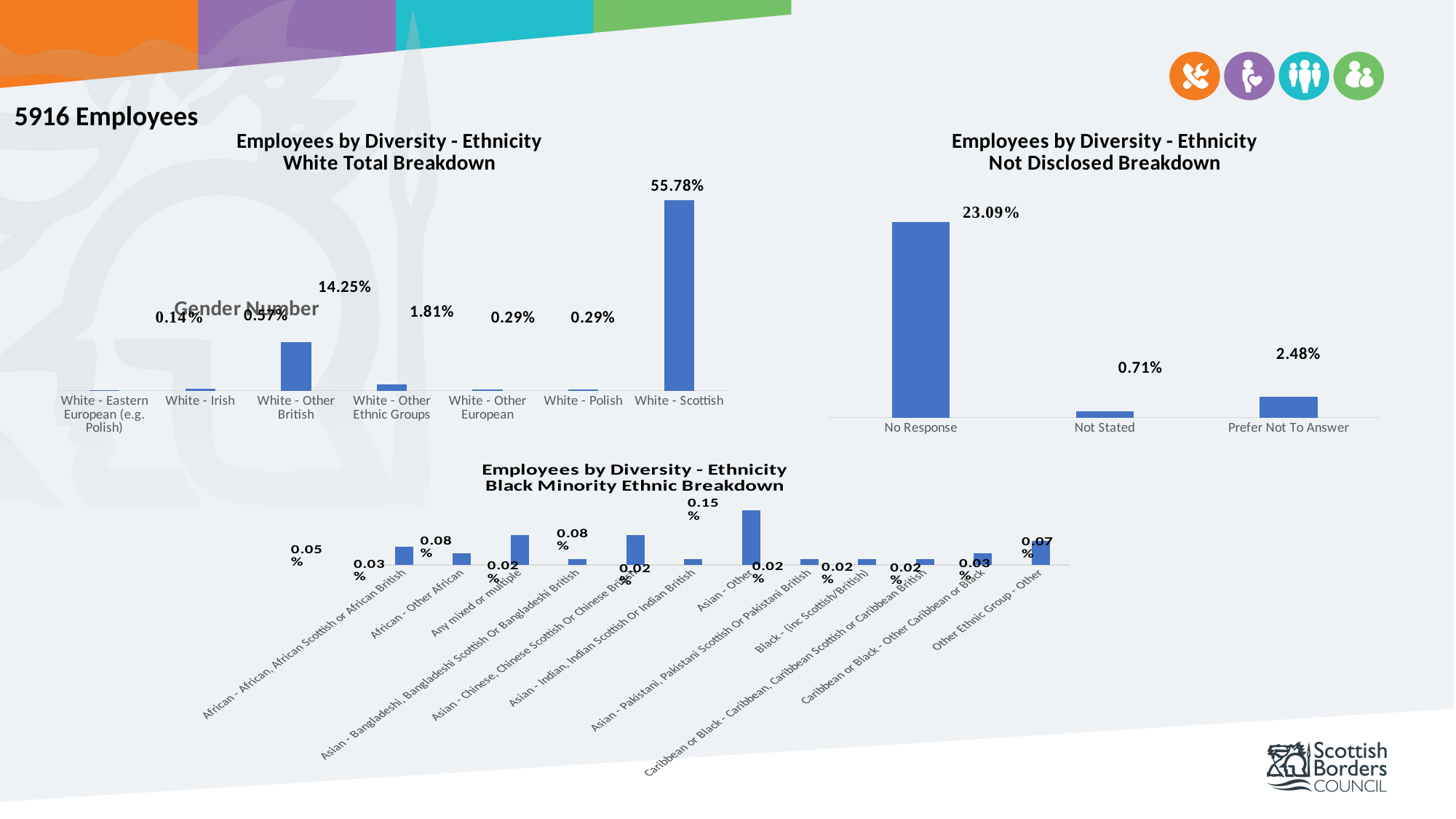
In the 'White Total Breakdown' chart, how many categories are shown? 7 In the 'Not Disclosed Breakdown' chart, what is the difference between Prefer Not To Answer and Not Stated? 1.77% In the 'White Total Breakdown' chart, what is the value for White - Other British? 14.25% In the 'White Total Breakdown' chart, which is larger: White - Irish or White - Other Ethnic Groups? White - Other Ethnic Groups In the 'White Total Breakdown' chart, what is the difference between White - Scottish and White - Other British? 41.53% In the 'White Total Breakdown' chart, which category has the lowest value? White - Eastern European (e.g. Polish) In the 'Not Disclosed Breakdown' chart, what is the value for Prefer Not To Answer? 2.48% What type of chart is the 'Not Disclosed Breakdown' chart? Bar chart In the 'White Total Breakdown' chart, what is the value for White - Scottish? 55.78% In the 'Not Disclosed Breakdown' chart, which category has the lowest value? Not Stated In the 'Not Disclosed Breakdown' chart, what is the value for No Response? 23.09% In the 'Black Minority Ethnic Breakdown' chart, how many categories are shown? 12